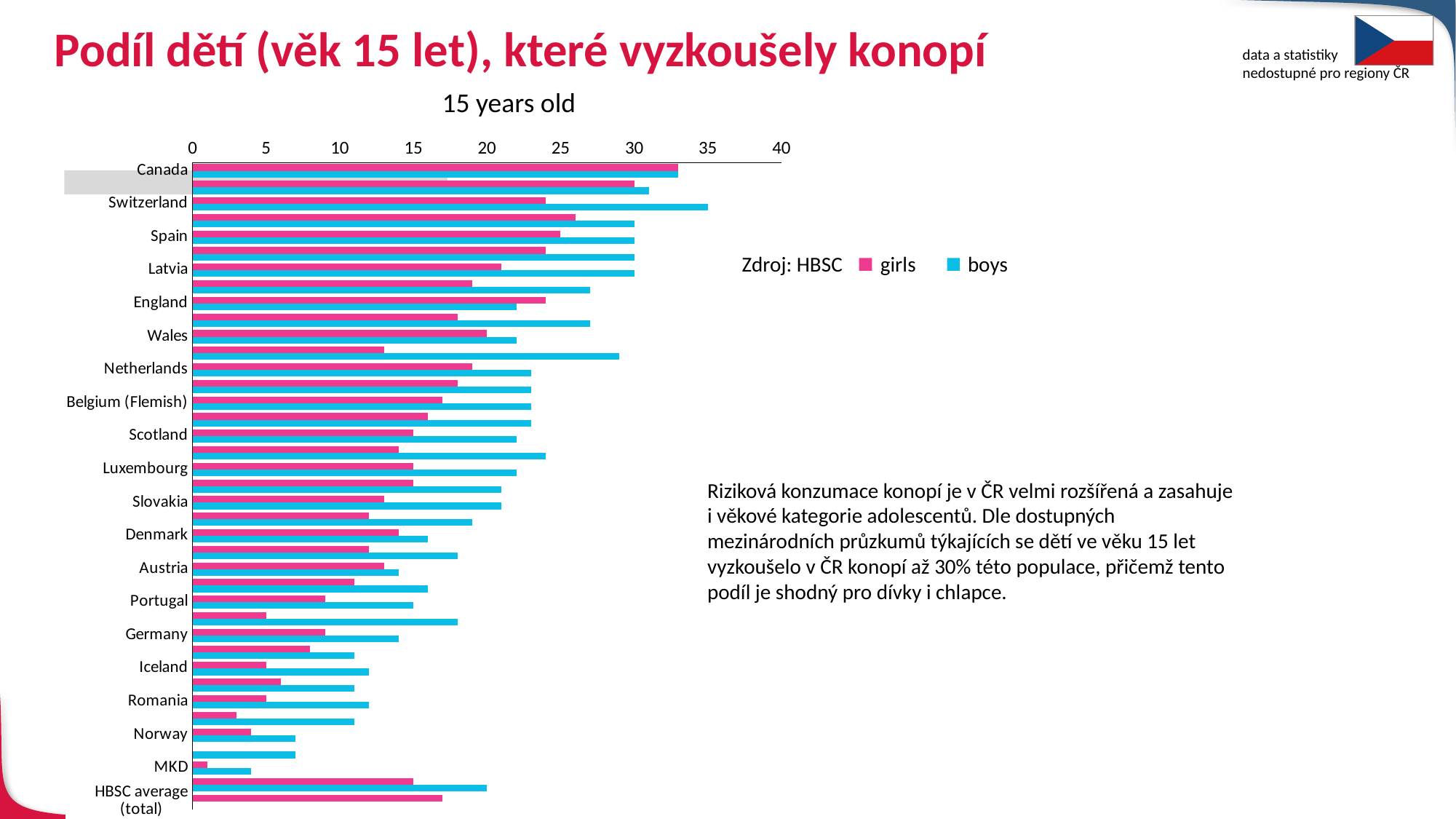
Is the value for boys in MKD greater or less than 5? less Is the value for boys in Switzerland greater or less than 30? greater Is the value for girls in Canada greater or less than 30? greater In Switzerland, which series has the larger value, girls or boys? boys What kind of chart is shown on the slide? bar chart In Canada, which series has the larger value, girls or boys? Neither; girls and boys are equal (both 33) Which labeled country has the lowest value for girls? MKD What are the two series named in the chart legend? girls and boys What is the title printed above the chart? 15 years old Which labeled country has the highest value for boys? Switzerland How many series does the chart legend list? 2